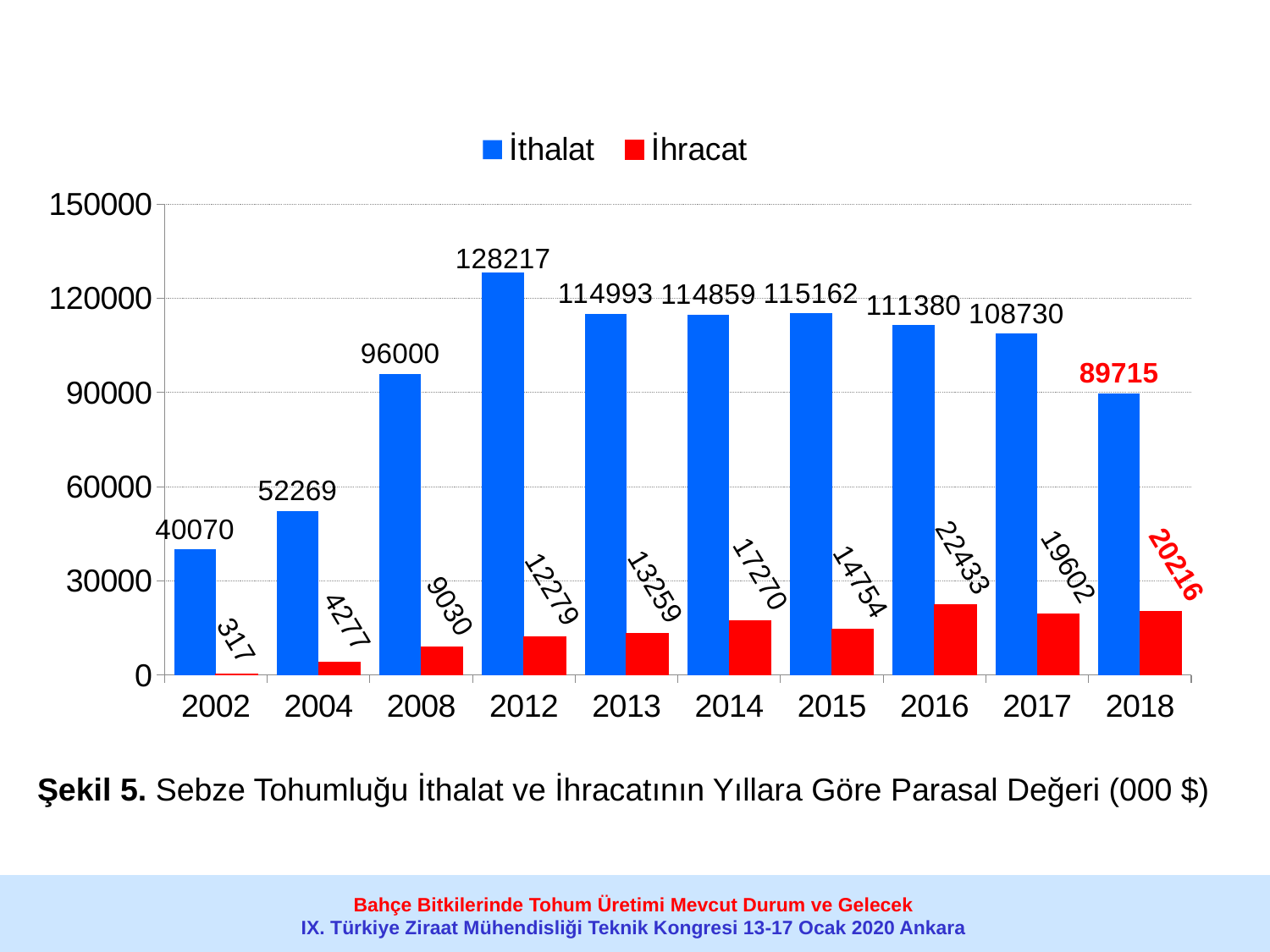
Which year has the lowest İhracat value? 2002 What is the difference between the İthalat and İhracat values in 2018? 69499 What is the İthalat value for 2018? 89715 Is the İthalat value for 2008 greater or less than 90000? greater What kind of chart is shown on the slide? bar chart What is the İhracat value for 2016? 22433 What is the İthalat value for 2012? 128217 How many series does the legend list? 2 Which is larger, the İhracat value for 2017 or for 2018? 2018 Which year has the highest İthalat value? 2012 Which colour represents İhracat in the chart? red How many years are shown on the x axis? 10